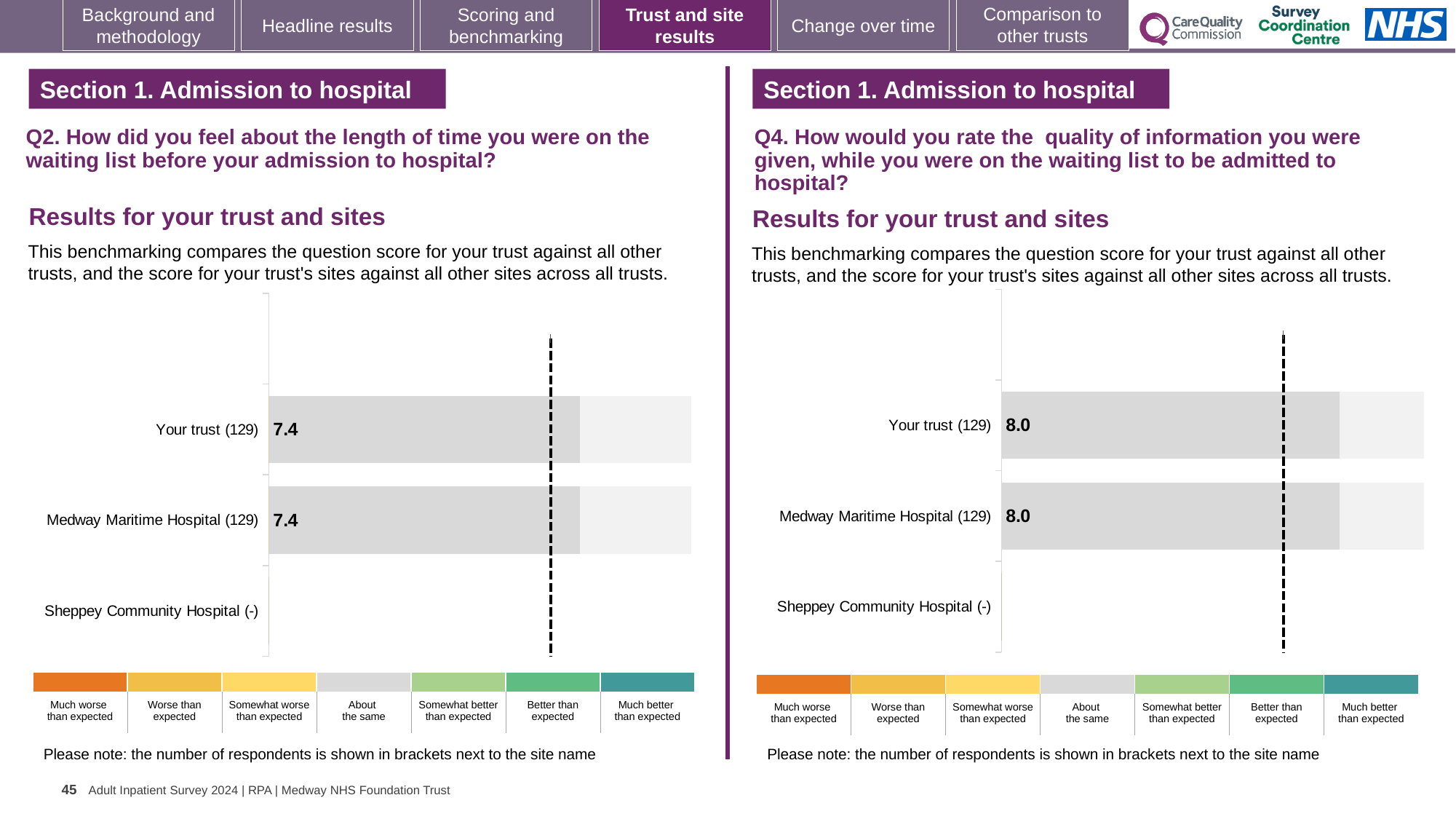
What kind of chart is the Q2 chart on the left? Bar chart In the Q2 chart on the left, which category has no score shown? Sheppey Community Hospital (-) In the Q4 chart on the right, what is the difference between the score for Your trust (129) and Medway Maritime Hospital (129)? 0.0 How many benchmark bands are shown in the colour key below the Q4 chart on the right? 7 In the Q2 chart on the left, what is the score for Medway Maritime Hospital (129)? 7.4 In the Q4 chart on the right, what is the score for Medway Maritime Hospital (129)? 8.0 In the Q2 chart on the left, what is the difference between the score for Your trust (129) and Medway Maritime Hospital (129)? 0.0 In the Q4 chart on the right, how many site/trust categories are listed on the vertical axis? 3 In the Q2 chart on the left, how many site/trust categories are listed on the vertical axis? 3 In the Q4 chart on the right, how many respondents are shown in brackets for Medway Maritime Hospital? 129 In the Q2 chart on the left, what is the score for Your trust (129)? 7.4 In the Q4 chart on the right, what is the score for Your trust (129)? 8.0